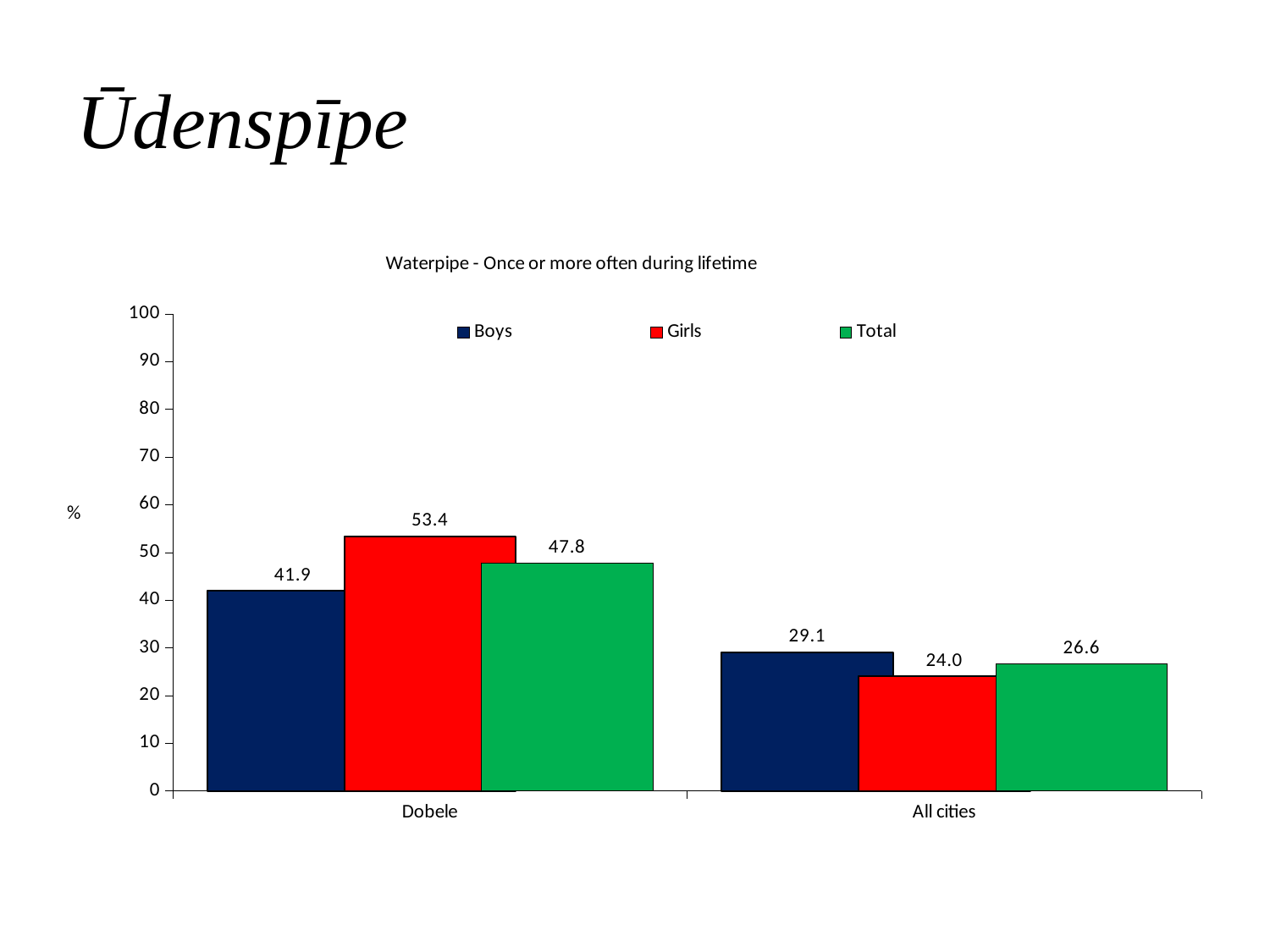
How many categories are shown on the x axis? 2 What is the value for Girls in Dobele? 53.4 Is the Total value for Dobele greater or less than 40? greater Which is larger, the Boys value in Dobele or the Boys value in All cities? Dobele What kind of chart is shown on the slide? bar chart Which series has the highest value in Dobele? Girls How many series does the legend list? 3 What is the value for Boys in All cities? 29.1 What is the title of the chart? Waterpipe - Once or more often during lifetime What is the value for Total in All cities? 26.6 What is the difference between the Girls value in Dobele and the Girls value in All cities? 29.4 Which series has the lowest value in All cities? Girls